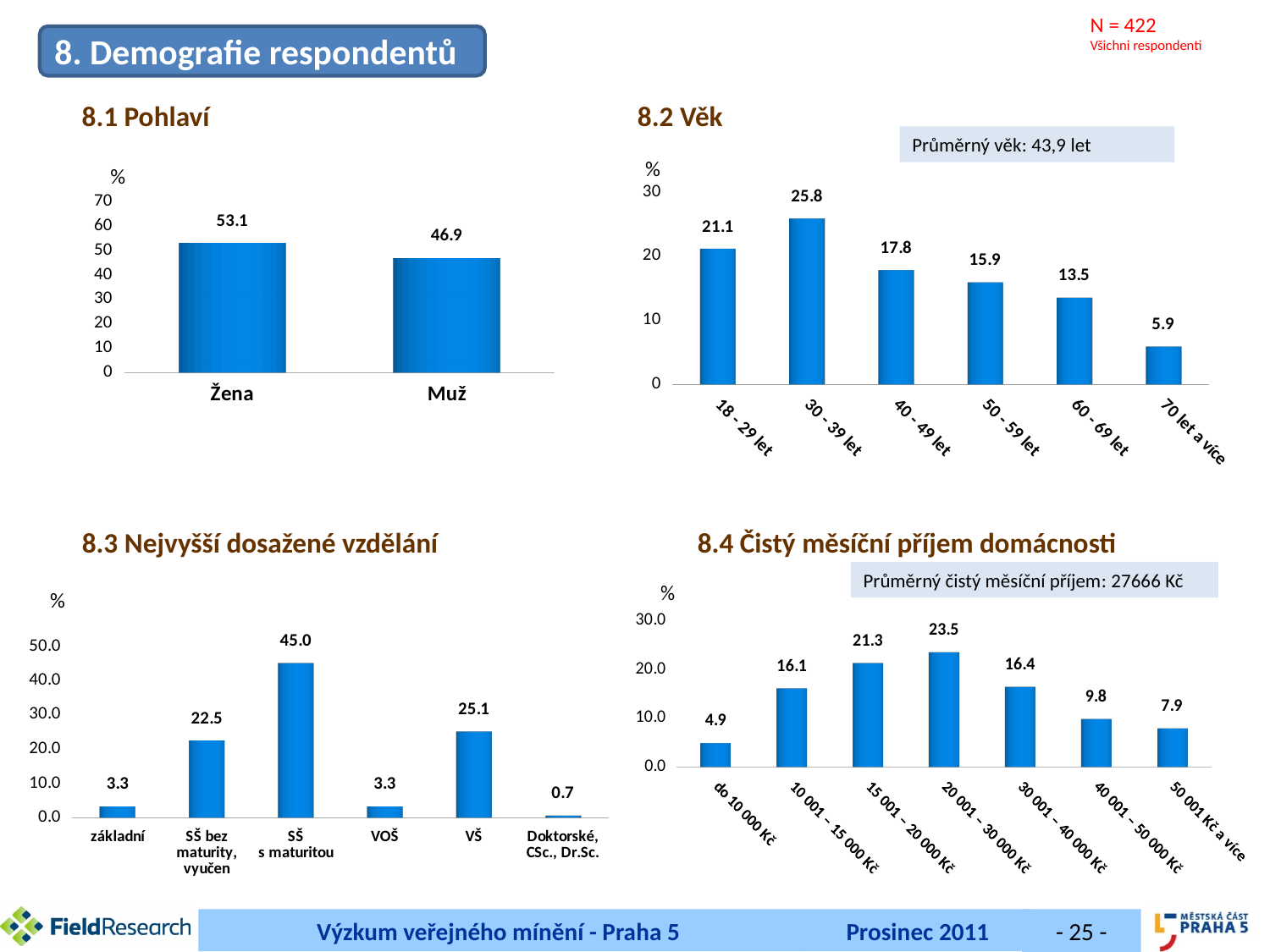
In the '8.3 Nejvyšší dosažené vzdělání' chart, what is the value for VŠ? 25.1 In the '8.2 Věk' chart, which age group has the highest value? 30 - 39 let In the '8.1 Pohlaví' chart, what is the difference between the values for Žena and Muž? 6.2 In the '8.2 Věk' chart, how many age categories are shown? 6 In the '8.1 Pohlaví' chart, what is the value for Žena? 53.1 In the '8.4 Čistý měsíční příjem domácnosti' chart, what is the value for 20 001 - 30 000 Kč? 23.5 In the '8.4 Čistý měsíční příjem domácnosti' chart, what is the difference between the values for 15 001 - 20 000 Kč and 40 001 - 50 000 Kč? 11.5 In the '8.2 Věk' chart, do the values rise or fall from 30 - 39 let to 70 let a více? fall In the '8.3 Nejvyšší dosažené vzdělání' chart, which category has the lowest value? Doktorské, CSc., Dr.Sc. What type of chart is the '8.4 Čistý měsíční příjem domácnosti' chart? bar chart In the '8.2 Věk' chart, what is the value for 60 - 69 let? 13.5 In the '8.3 Nejvyšší dosažené vzdělání' chart, which is larger: the value for SŠ bez maturity, vyučen or the value for VŠ? VŠ